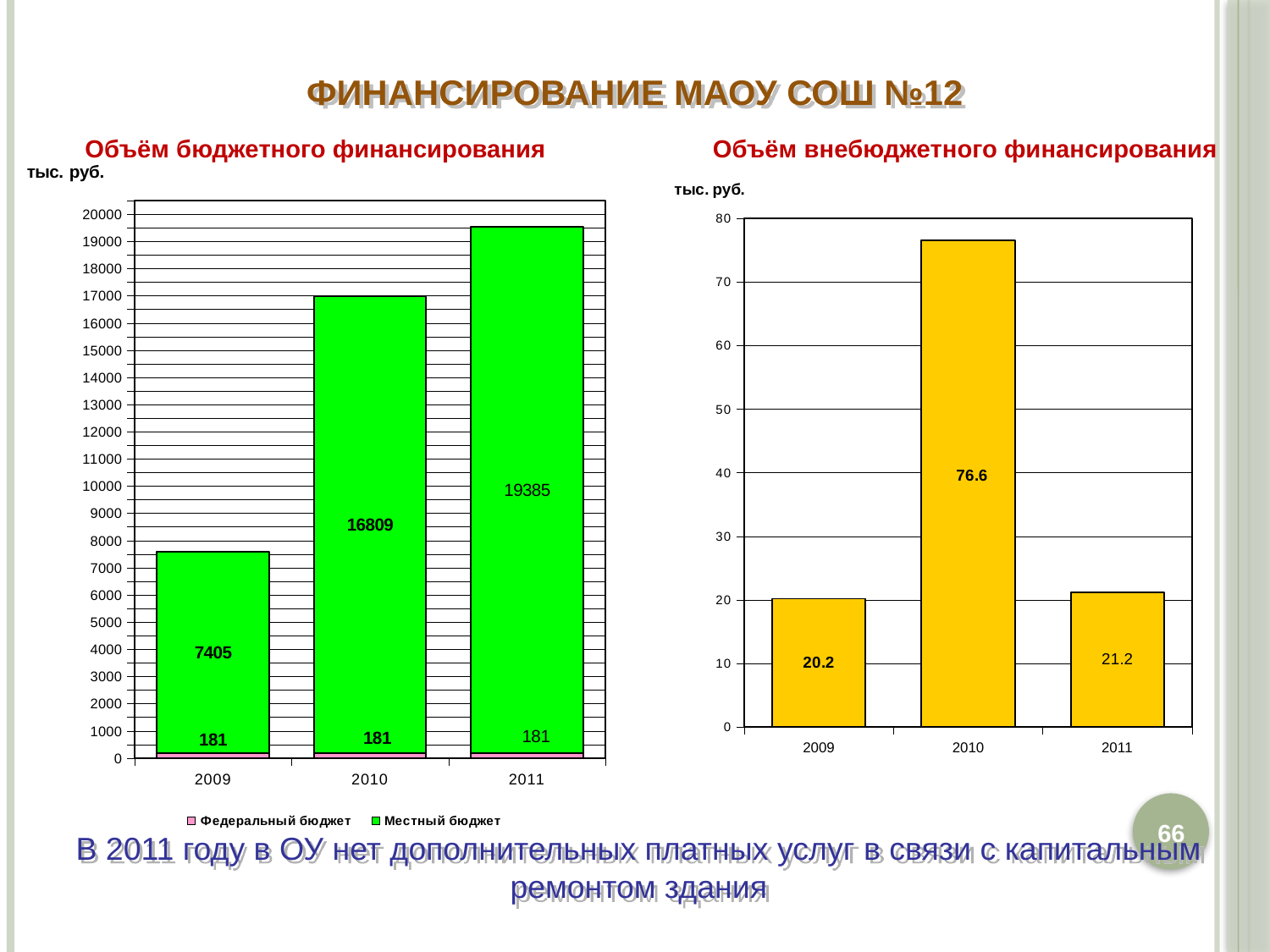
In the chart 'Объём внебюджетного финансирования', what is the difference between the values for 2010 and 2011? 55.4 In the chart 'Объём бюджетного финансирования', which year has the highest value for Местный бюджет? 2011 In the chart 'Объём внебюджетного финансирования', is the value for 2011 larger than the value for 2009? Yes In the chart 'Объём бюджетного финансирования', what is the value for Федеральный бюджет in 2011? 181 In the chart 'Объём внебюджетного финансирования', how many years are shown on the x axis? 3 In the chart 'Объём бюджетного финансирования', what is the total of the stacked bar for 2009? 7586 In the chart 'Объём бюджетного финансирования', what is the difference between the Местный бюджет values for 2011 and 2010? 2576 In the chart 'Объём внебюджетного финансирования', what is the value for 2010? 76.6 In the chart 'Объём бюджетного финансирования', how many series does the legend list? 2 In the chart 'Объём бюджетного финансирования', what is the value for Местный бюджет in 2010? 16809 What kind of chart is 'Объём внебюджетного финансирования'? Bar chart In the chart 'Объём внебюджетного финансирования', which year has the lowest value? 2009